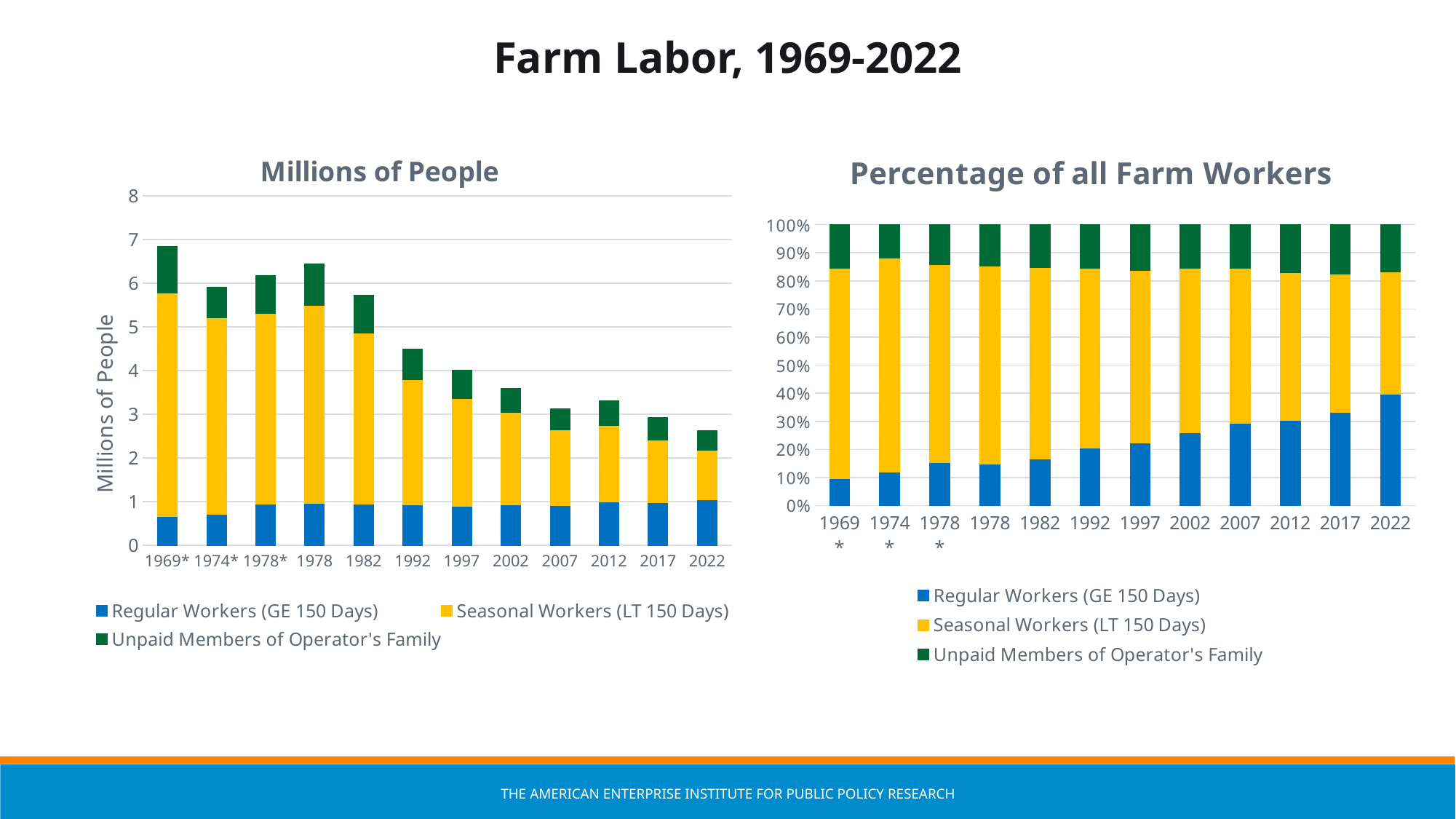
Which series is shown in green in both charts? Unpaid Members of Operator's Family How many year categories are shown on the x axis of the "Millions of People" chart? 12 In the "Millions of People" chart, which year has the tallest stacked bar? 1969* What kind of chart is the "Millions of People" chart? bar chart In the "Millions of People" chart, do the total bar heights generally rise or fall from 1969* to 2022? fall How many series does the legend of the "Percentage of all Farm Workers" chart list? 3 In the "Percentage of all Farm Workers" chart, does the share of Regular Workers (GE 150 Days) rise or fall from 1969* to 2022? rise In the "Millions of People" chart, is the total bar height for 1969* greater or less than 6? greater In the "Percentage of all Farm Workers" chart, is the share of Regular Workers (GE 150 Days) in 2022 greater or less than 30%? greater In the "Millions of People" chart, is the total bar height for 2022 greater or less than 3? less In the "Millions of People" chart, which year has the shortest stacked bar? 2022 In the "Percentage of all Farm Workers" chart, which series has the largest share in 1969*? Seasonal Workers (LT 150 Days)